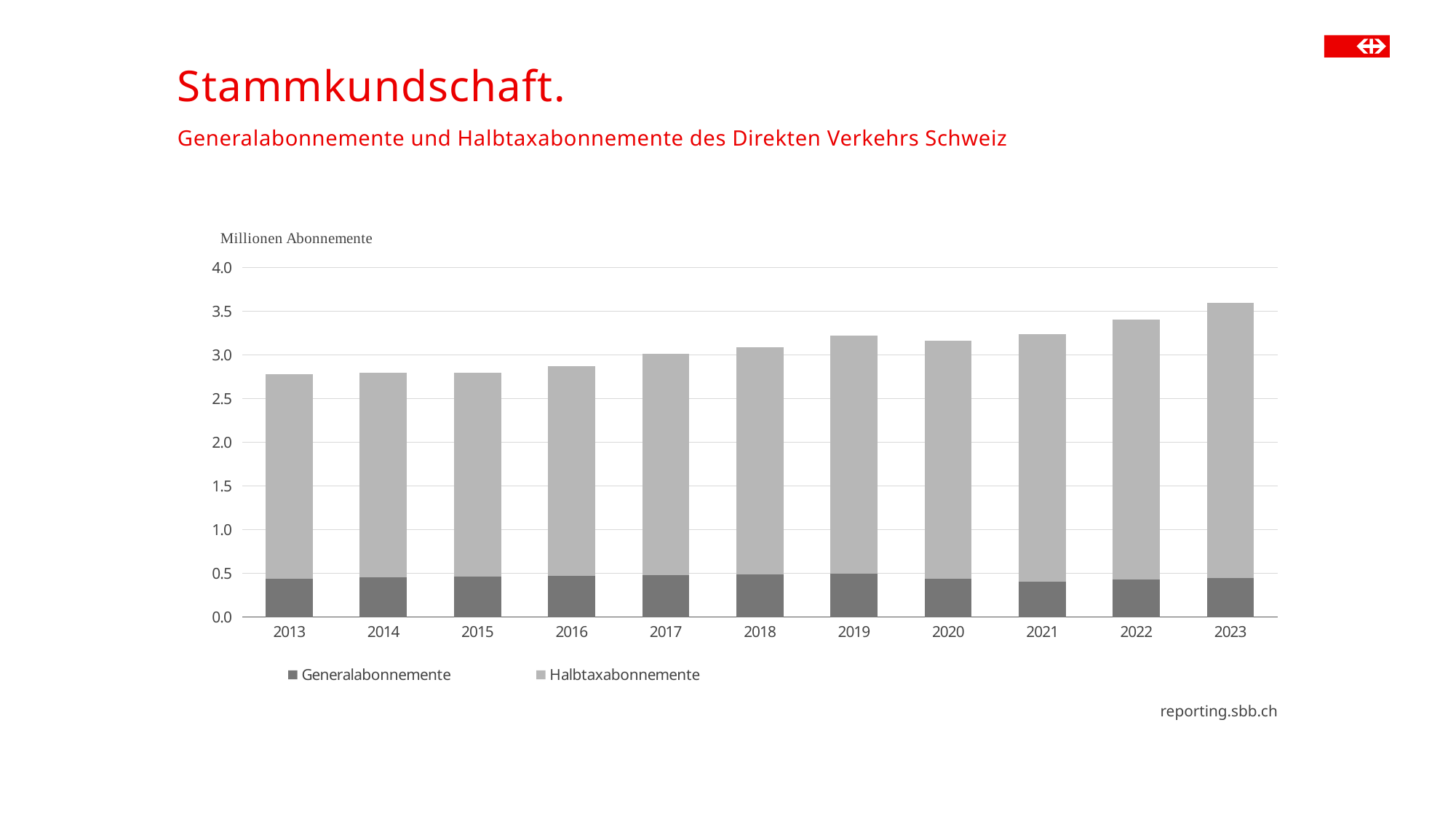
Which year has the larger total bar, 2020 or 2022? 2022 Is the Generalabonnemente value for 2013 greater or less than 0.5? less Do the total bar heights generally rise or fall from 2013 to 2023? Rise Is the total value for 2022 greater or less than 3.5? less Which year has the larger total bar, 2013 or 2023? 2023 Which year has the highest total number of subscriptions in the chart? 2023 What unit label is shown above the y axis of the chart? Millionen Abonnemente How many years are shown on the x axis of the chart? 11 Is the total value for 2013 greater or less than 3.0? less What kind of chart is shown on the slide? Stacked bar chart How many series does the chart's legend list? 2